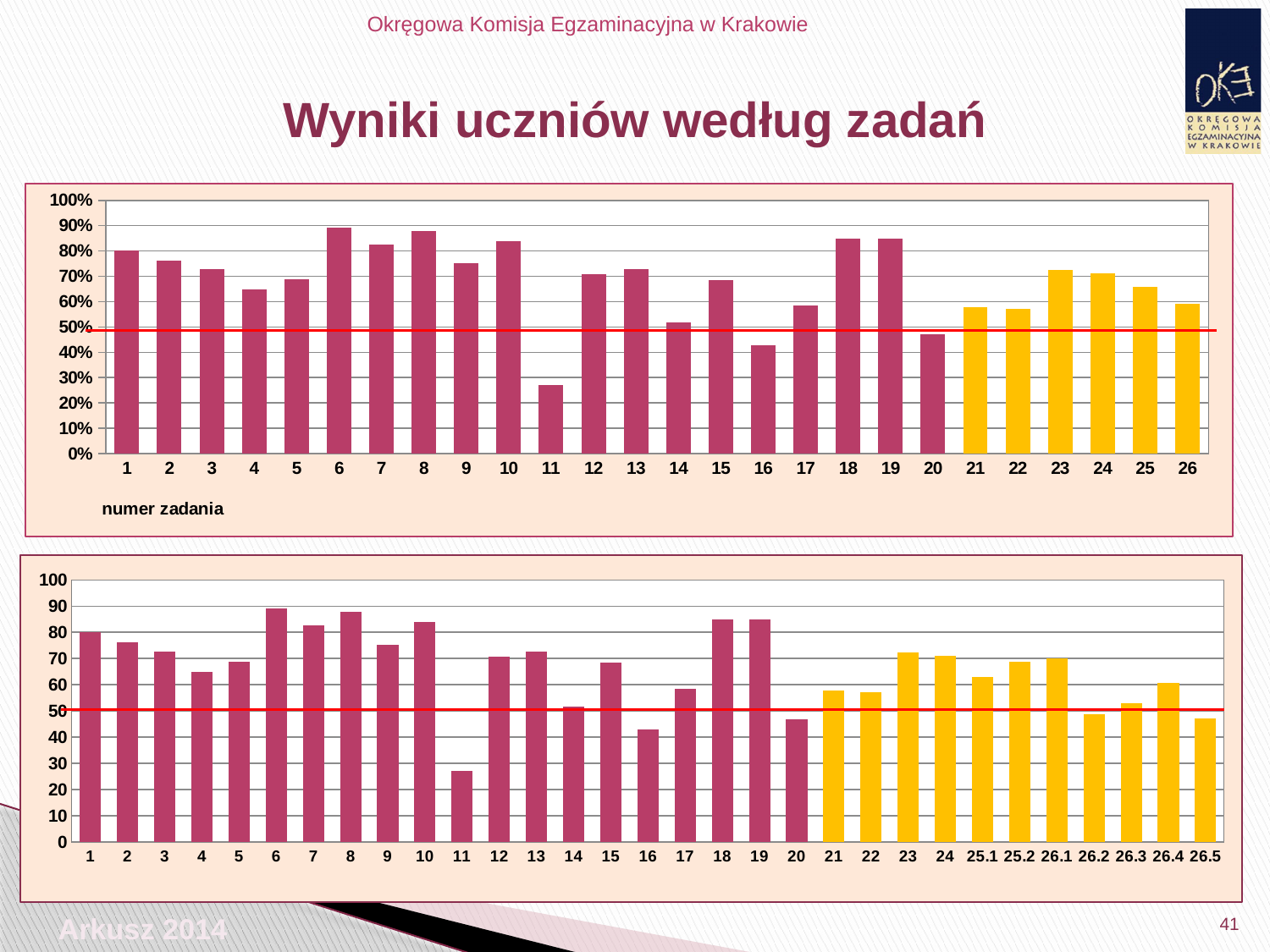
In the top chart, which task number has the lowest bar? 11 In the top chart, how many task numbers are shown on the x axis? 26 In the top chart, is the value for task 16 greater or less than 50%? less In the top chart, which has the higher value, task 1 or task 4? task 1 In the bottom chart, is the value for task 26.4 greater or less than 50? greater In the bottom chart, which has the higher value, task 18 or task 20? task 18 In the bottom chart, which task number has the lowest bar? 11 What kind of chart is the top chart on the slide? bar chart What is the x-axis label shown on the top chart? numer zadania In the bottom chart, how many bars are plotted? 31 In the top chart, is the value for task 11 greater or less than 40%? less